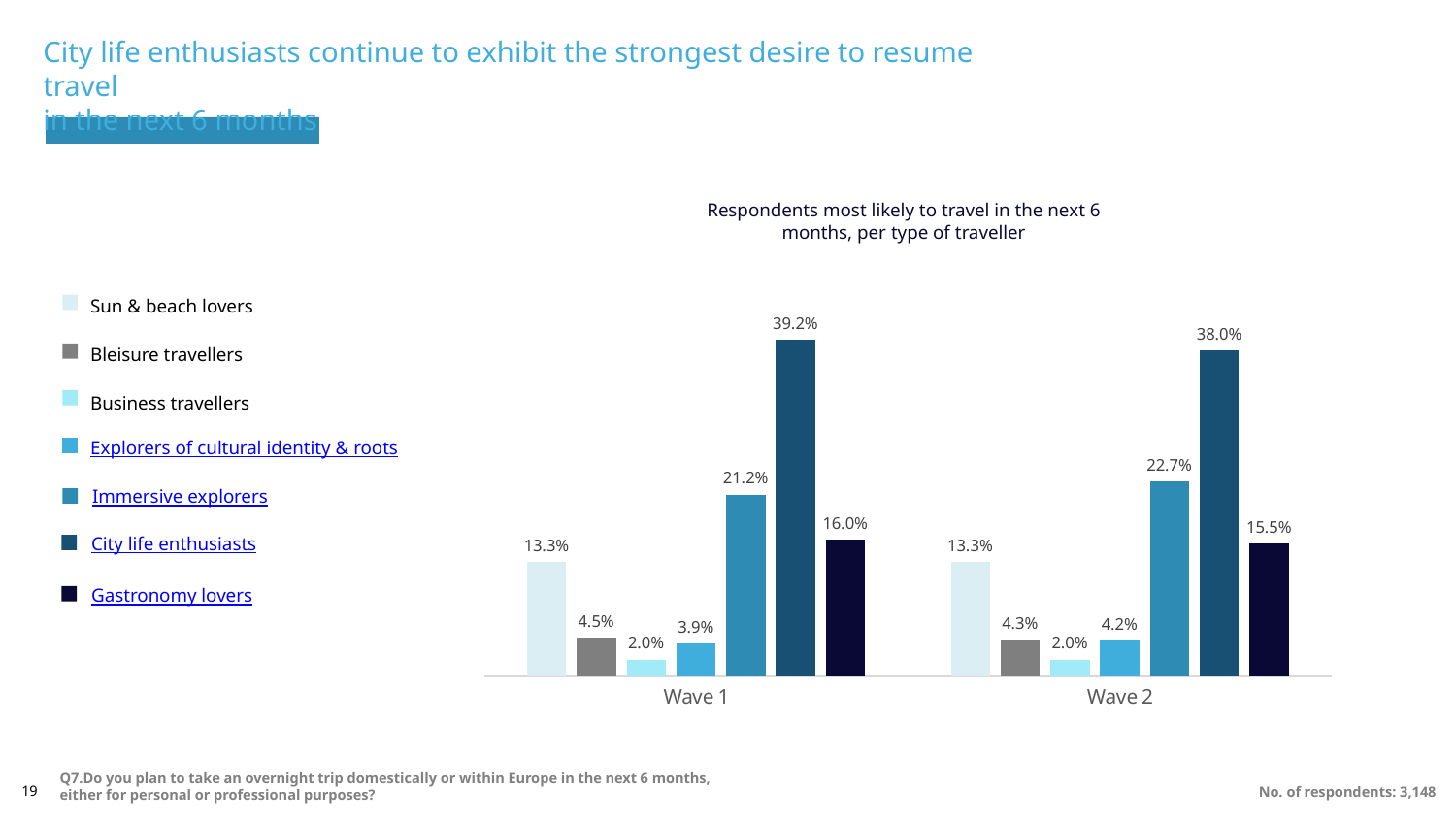
What is the value for Gastronomy lovers in Wave 1? 16.0% What is the value for Immersive explorers in Wave 2? 22.7% What is the value for Bleisure travellers in Wave 2? 4.3% How many categories are shown on the x axis? 2 What is the title of the chart? Respondents most likely to travel in the next 6 months, per type of traveller What kind of chart is shown on the slide? Bar chart Which is larger: Immersive explorers in Wave 1 or Immersive explorers in Wave 2? Wave 2 Which type of traveller has the highest value in Wave 2? City life enthusiasts How many series does the legend list? 7 What is the difference between the City life enthusiasts values in Wave 1 and Wave 2? 1.2% Which type of traveller has the lowest value in Wave 1? Business travellers What is the value for City life enthusiasts in Wave 1? 39.2%